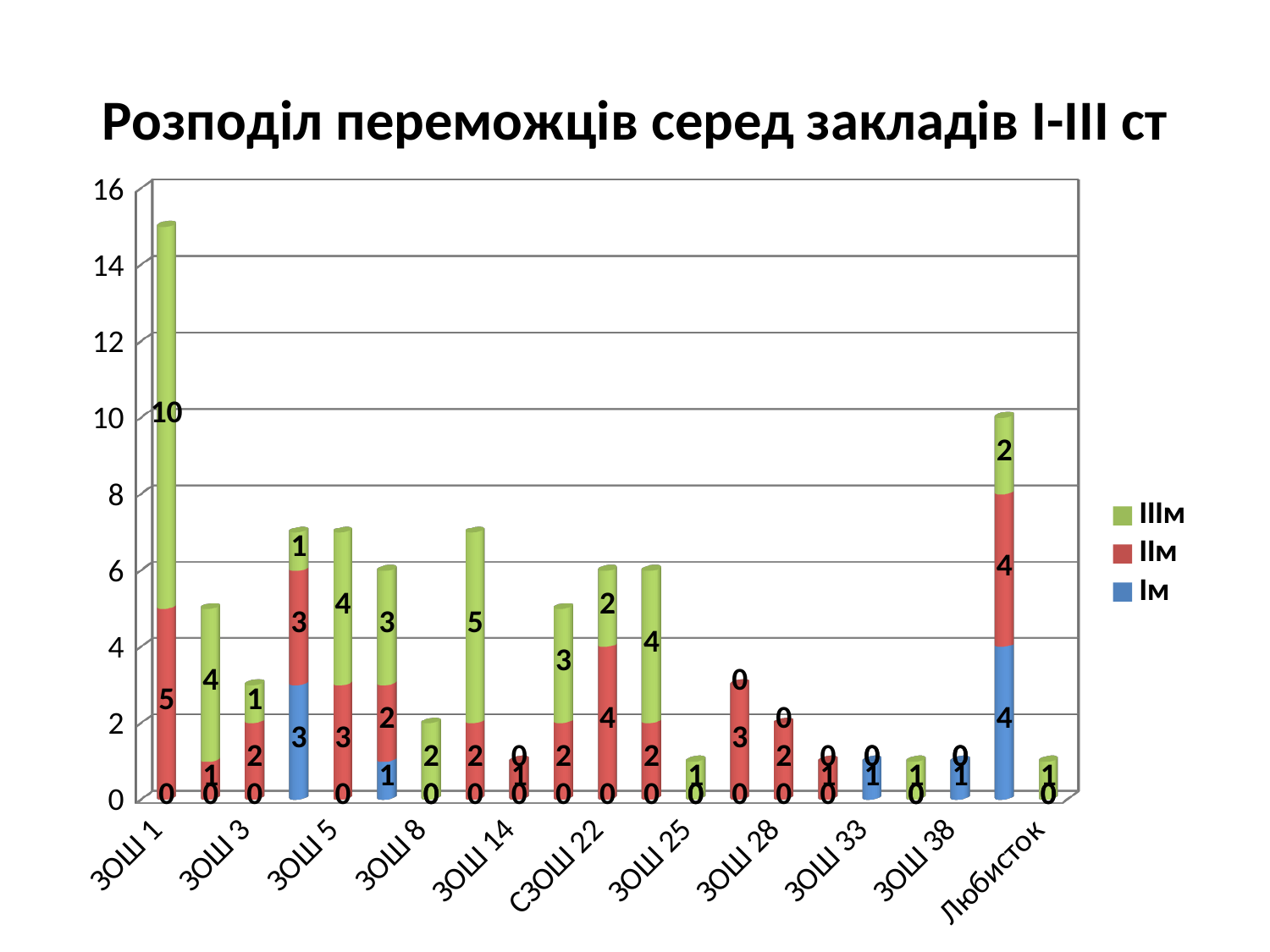
What is the title of the chart? Розподіл переможців серед закладів І-ІІІ ст What kind of chart is shown on the slide? stacked bar chart What is the value of the IIм series for ЗОШ 1? 5 What is the value of the IIм series for СЗОШ 22? 4 How many series does the legend list? 3 What is the value of the Iм series for ЗОШ 33? 1 What is the value of the IIIм series for ЗОШ 5? 4 What is the total of the stacked bar for СЗОШ 22? 6 What is the total of the stacked bar for ЗОШ 1? 15 What is the value of the IIIм series for ЗОШ 1? 10 Which labeled category has the highest total bar? ЗОШ 1 Which is larger: the IIIм value for ЗОШ 1 or the IIIм value for ЗОШ 5? ЗОШ 1